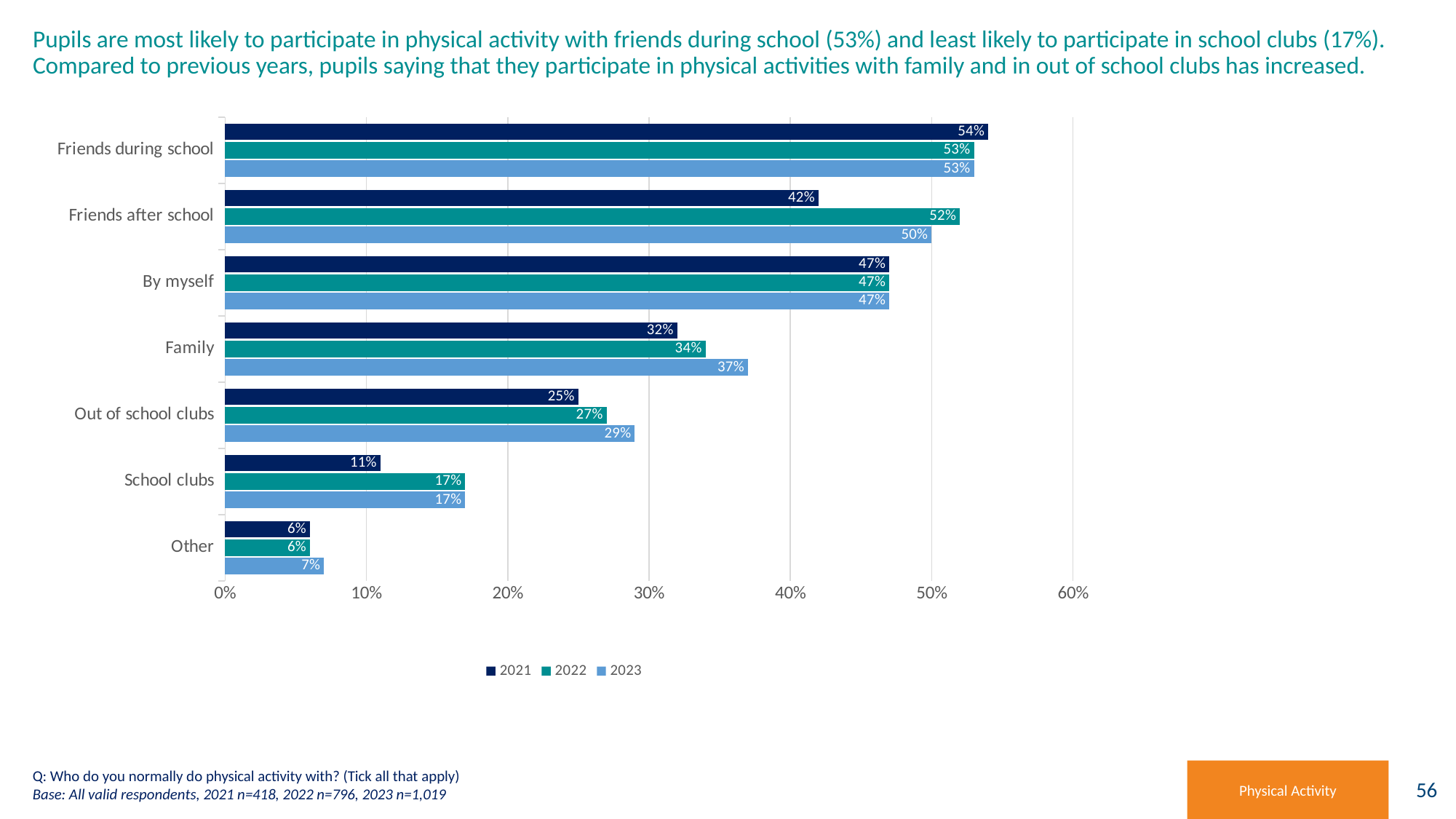
What was the value for Family in 2021? 32% What kind of chart is shown on the slide? Bar chart Did the value for Family rise or fall from 2021 to 2023? Rise Which category had the lowest value in 2023? Other What percentage of pupils said they do physical activity with friends during school in 2023? 53% Which is larger for School clubs: the 2021 value or the 2022 value? 2022 How many series does the legend list? 3 What was the value for Out of school clubs in 2022? 27% Which category had the highest value in 2021? Friends during school Which years are listed in the chart legend? 2021, 2022, 2023 What is the difference between the 2022 and 2021 values for Friends after school? 10% How many categories are shown on the y axis of the chart? 7